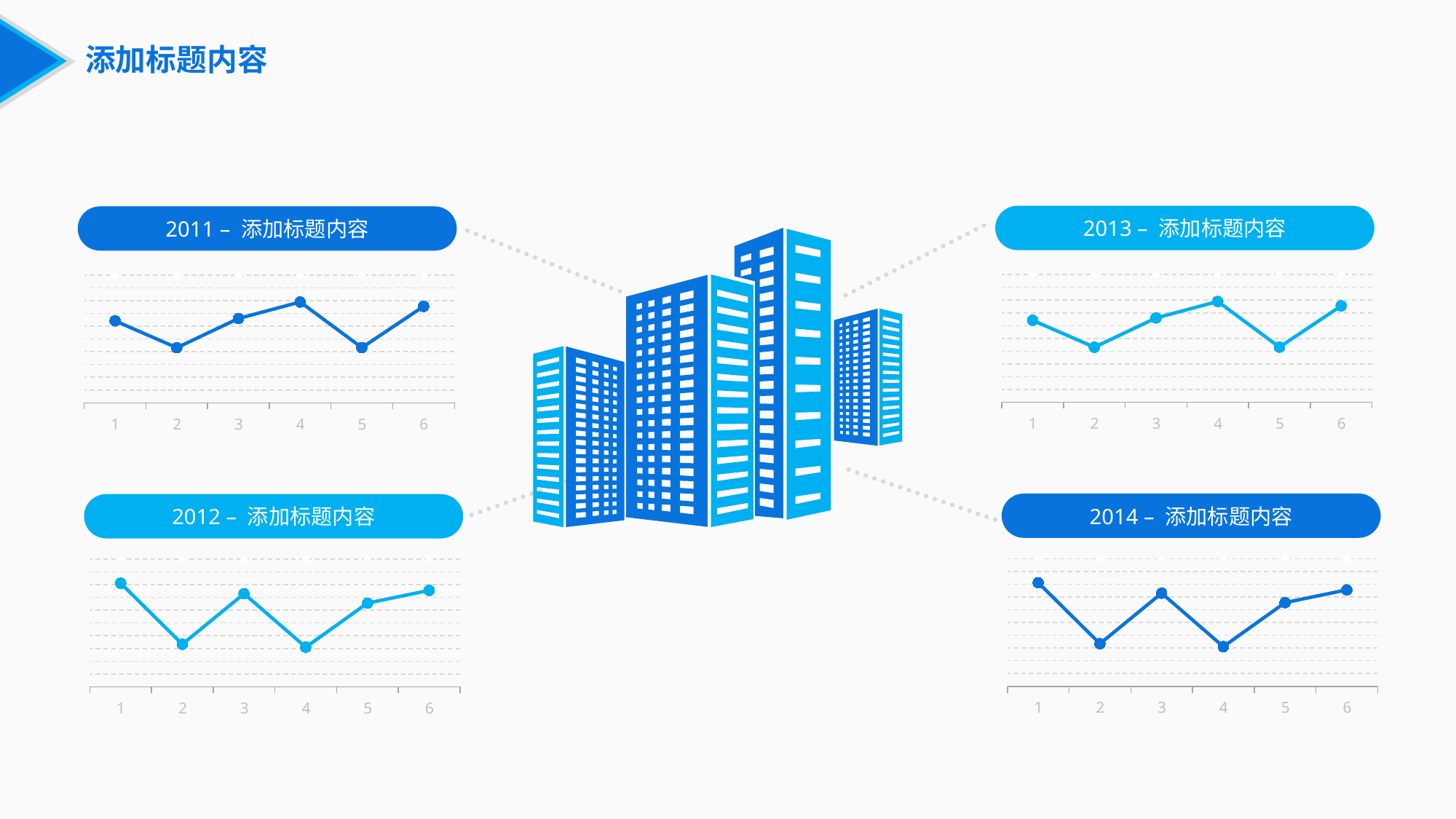
In the chart titled "2012 – 添加标题内容", which is higher, the value at point 1 or the value at point 2? point 1 In the chart titled "2011 – 添加标题内容", which is higher, the value at point 1 or the value at point 2? point 1 In the chart titled "2013 – 添加标题内容", does the value rise or fall from point 5 to point 6? rise How many data points are plotted in the chart titled "2012 – 添加标题内容"? 6 What kind of chart is the chart titled "2011 – 添加标题内容"? line chart In the chart titled "2013 – 添加标题内容", which is higher, the value at point 4 or the value at point 5? point 4 How many charts are shown on the slide? 4 In the chart titled "2014 – 添加标题内容", does the value rise or fall from point 1 to point 2? fall What is the title of the chart in the top-left of the slide? 2011 – 添加标题内容